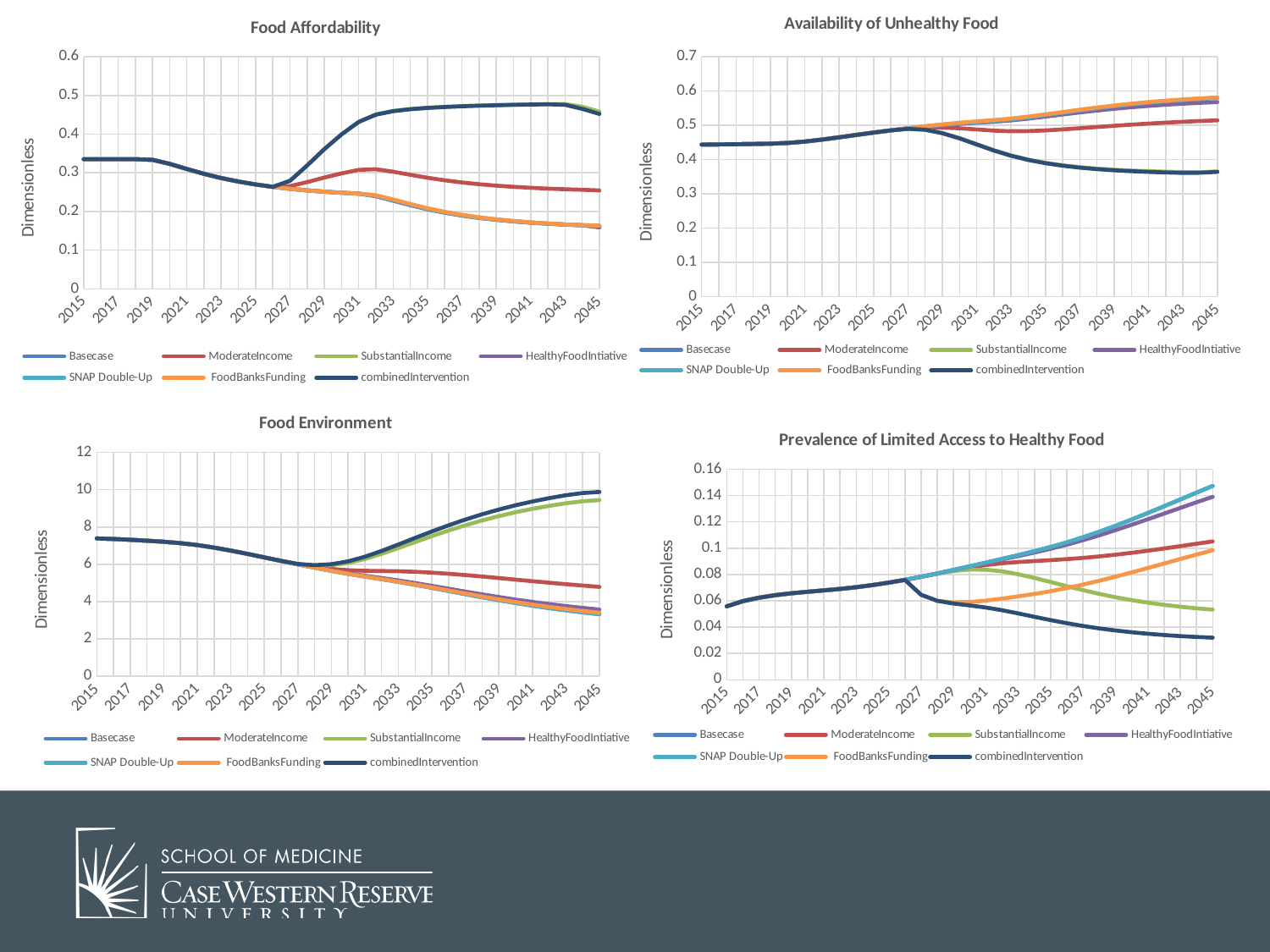
In the "Food Environment" chart, is the value for combinedIntervention in 2045 greater or less than 8? greater What is the y-axis label of the "Food Environment" chart? Dimensionless What kind of chart is the "Food Affordability" chart? line chart In the "Prevalence of Limited Access to Healthy Food" chart, does the SubstantialIncome line rise or fall from 2031 to 2045? fall In the "Food Affordability" chart, how many series does the legend list? 7 In the "Prevalence of Limited Access to Healthy Food" chart, which is higher in 2045, SNAP Double-Up or SubstantialIncome? SNAP Double-Up In the "Food Environment" chart, which is higher in 2045, combinedIntervention or ModerateIncome? combinedIntervention In the "Food Environment" chart, is the value for ModerateIncome in 2045 greater or less than 6? less In the "Prevalence of Limited Access to Healthy Food" chart, is the value for combinedIntervention in 2045 greater or less than 0.04? less In the "Availability of Unhealthy Food" chart, does the combinedIntervention line rise or fall from 2027 to 2045? fall